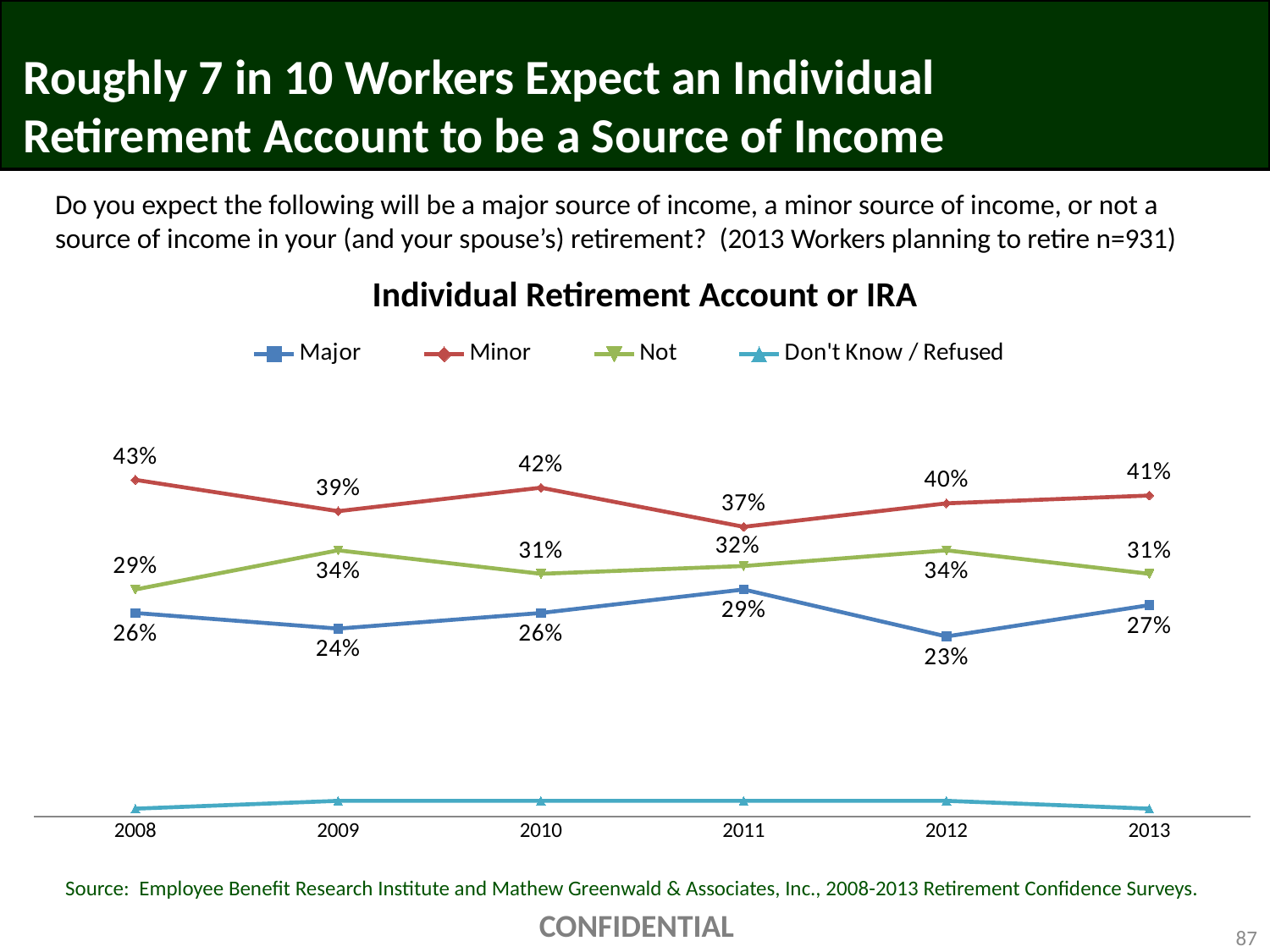
What kind of chart is shown on the slide? line chart What is the difference between the Minor and Major values in 2013? 14% How many series does the legend list? 4 How many years are shown on the x axis? 6 What is the value for Not in 2013? 31% Does the Minor series rise or fall from 2008 to 2009? fall What is the title of the chart? Individual Retirement Account or IRA Which is larger in 2009, the Not value or the Major value? Not In which year is the Minor series at its lowest? 2011 What is the value for Major in 2012? 23% In which year is the Major series at its highest? 2011 What is the value for Minor in 2008? 43%